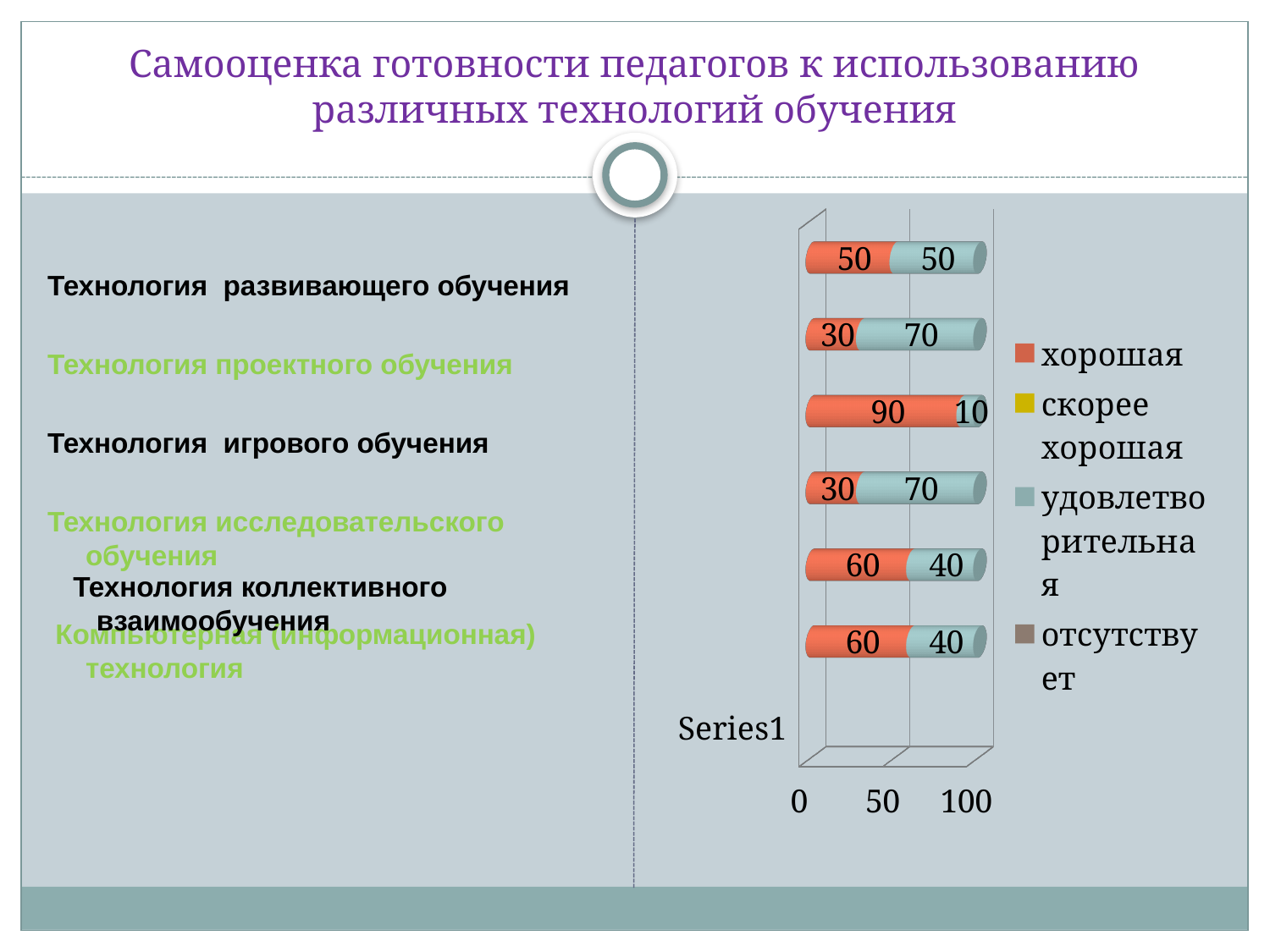
What is the difference between the red segment of the third bar from the top and the red segment of the top bar? 40 In the bottom bar, which segment is larger, the red (хорошая) or the blue-grey (удовлетворительная)? red (хорошая) What is the value of the red (хорошая) segment in the top bar? 50 Which bar has the largest red (хорошая) segment? the third bar from the top What kind of chart is shown on the slide? bar chart How many series does the chart legend list? 4 How many bars are plotted in the chart? 6 What is the value of the blue-grey (удовлетворительная) segment in the bottom bar? 40 What is the total of the stacked segments in the third bar from the top? 100 What is the value of the blue-grey (удовлетворительная) segment in the second bar from the top? 70 What is the value of the red (хорошая) segment in the third bar from the top? 90 Which legend entry is shown in red? хорошая